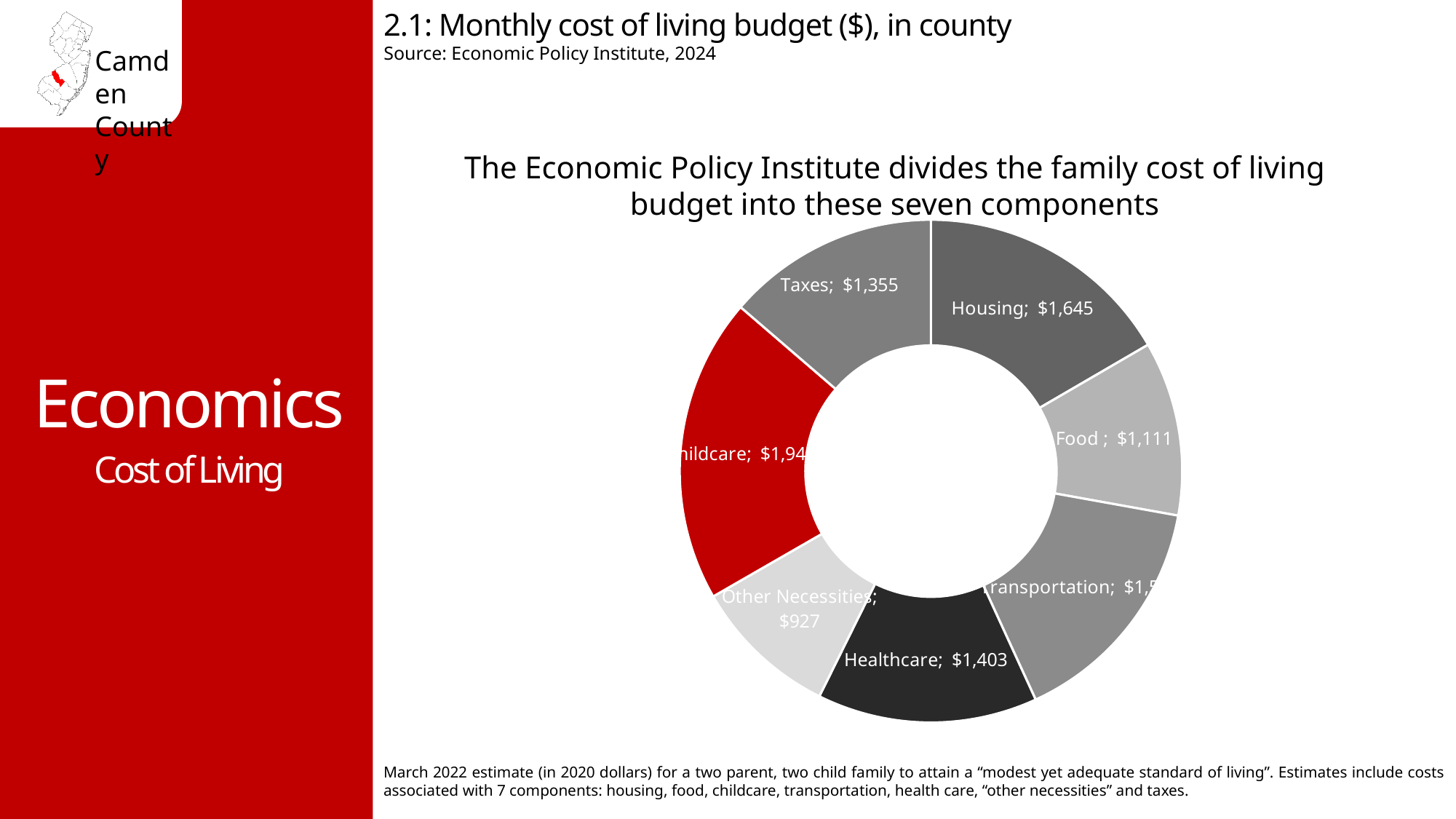
What is the monthly cost for Healthcare in the chart? $1,403 What is the monthly cost for Taxes in the chart? $1,355 What kind of chart is shown on the slide? Pie (donut) chart What is the monthly cost for Other Necessities in the chart? $927 Which component has the largest monthly cost in the chart? Childcare What is the monthly cost for Housing in the chart? $1,645 What is the difference between the Healthcare and Food monthly costs? $292 What is the difference between the Housing and Taxes monthly costs? $290 What is the monthly cost for Food in the chart? $1,111 Which is larger, the monthly cost for Housing or for Healthcare? Housing Which component has the smallest monthly cost in the chart? Other Necessities How many components are shown in the chart? 7